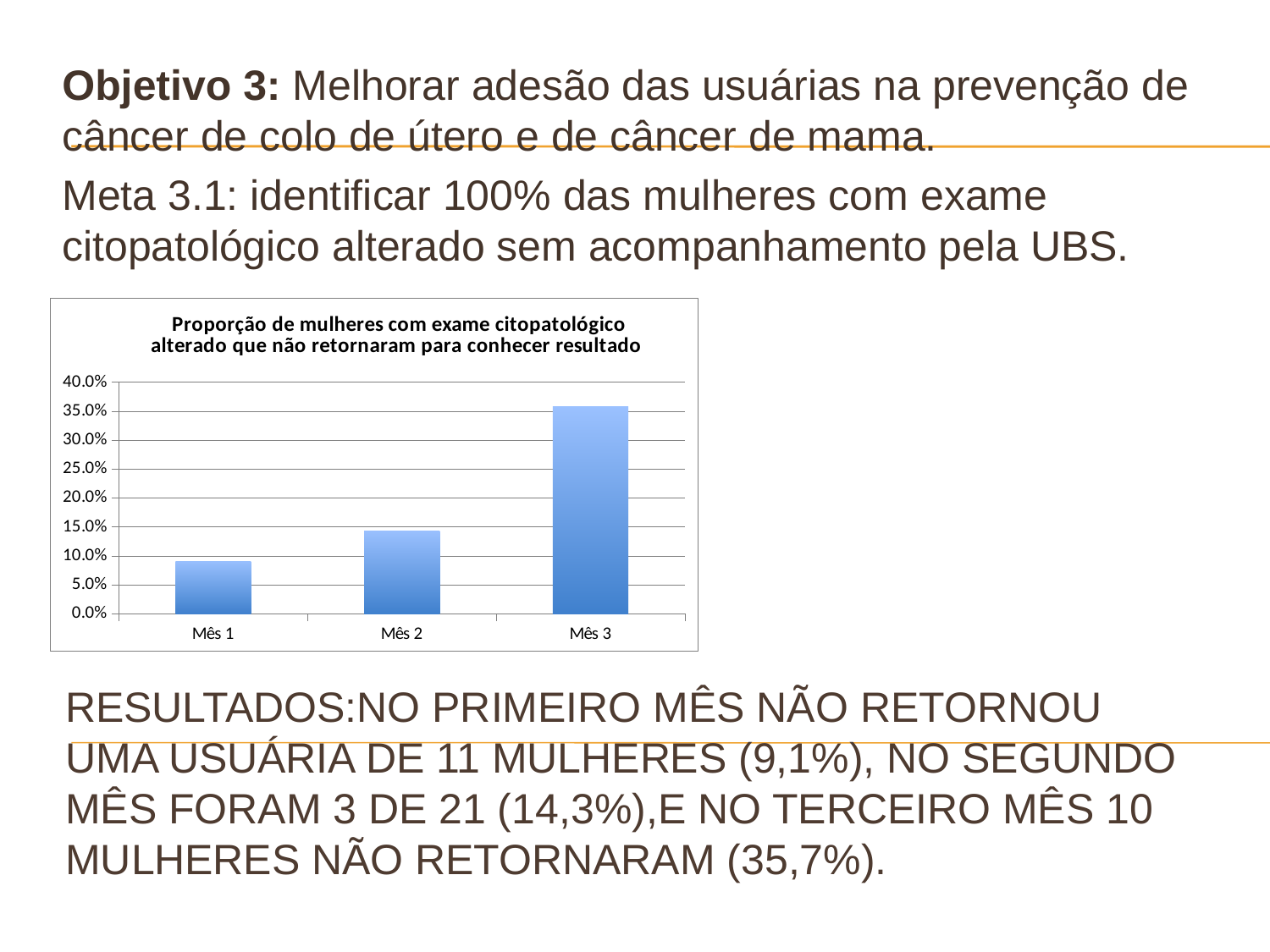
Do the values rise or fall from Mês 1 to Mês 3? rise Is the value for Mês 2 greater or less than 20.0%? less Is the value for Mês 2 greater or less than 10.0%? greater Which month has the highest proportion in the chart? Mês 3 What is the title of the chart? Proporção de mulheres com exame citopatológico alterado que não retornaram para conhecer resultado What kind of chart is shown on the slide? bar chart Is the value for Mês 1 greater or less than 5.0%? greater Which is larger, the value for Mês 2 or the value for Mês 1? Mês 2 How many categories (months) are plotted on the x axis of the chart? 3 Which month has the lowest proportion in the chart? Mês 1